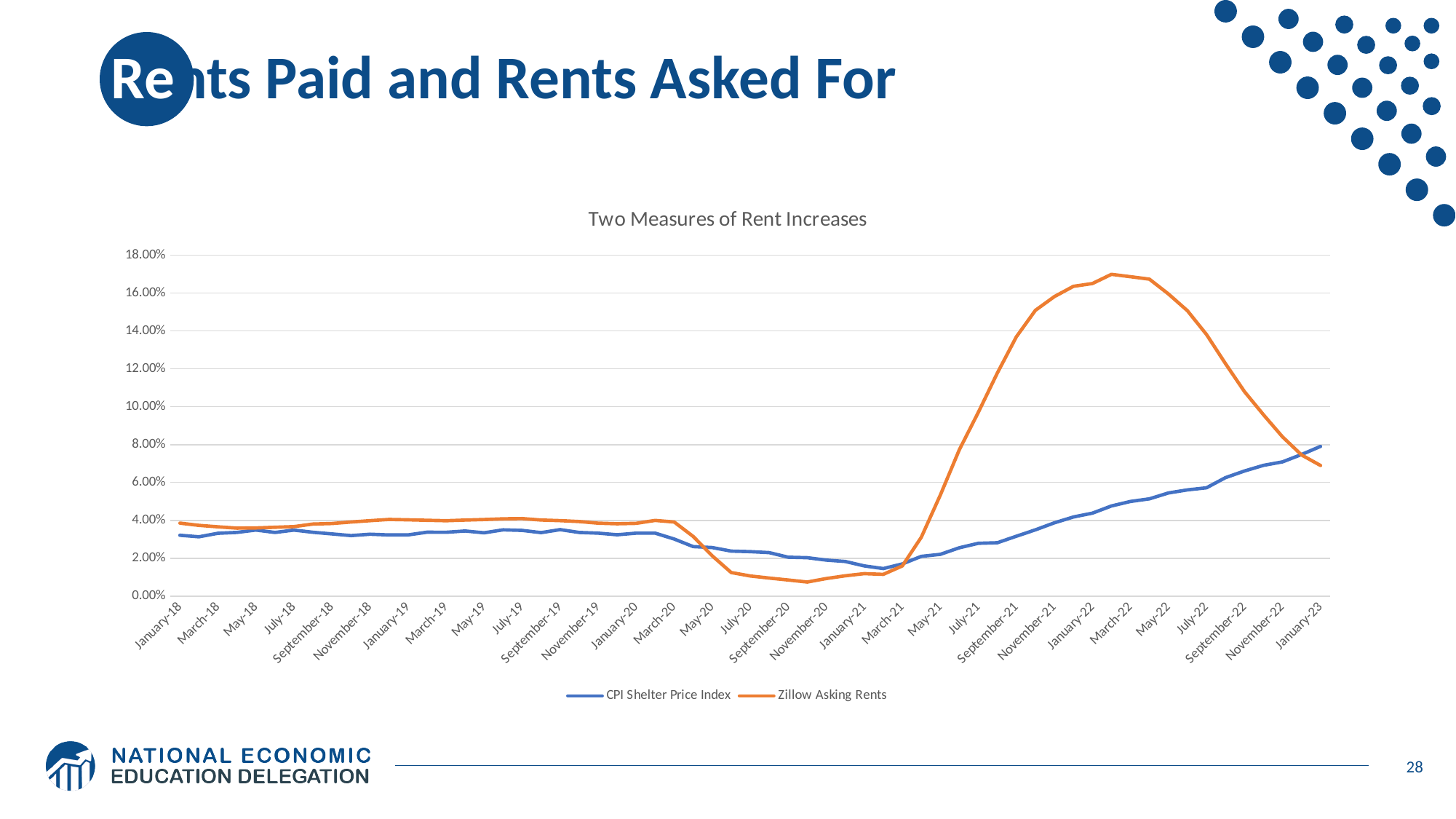
Is the value for Zillow Asking Rents in March-22 greater or less than 16.00%? greater What colour is the Zillow Asking Rents line? orange Is the value for Zillow Asking Rents in September-20 greater or less than 2.00%? less Is the value for Zillow Asking Rents in January-23 greater or less than 8.00%? less What kind of chart is shown on the slide? line chart In March-22, which series has the higher value, CPI Shelter Price Index or Zillow Asking Rents? Zillow Asking Rents How many series does the legend list? 2 In September-20, which series has the higher value, CPI Shelter Price Index or Zillow Asking Rents? CPI Shelter Price Index What is the title of the chart? Two Measures of Rent Increases Does the CPI Shelter Price Index rise or fall from May-21 to January-23? rise